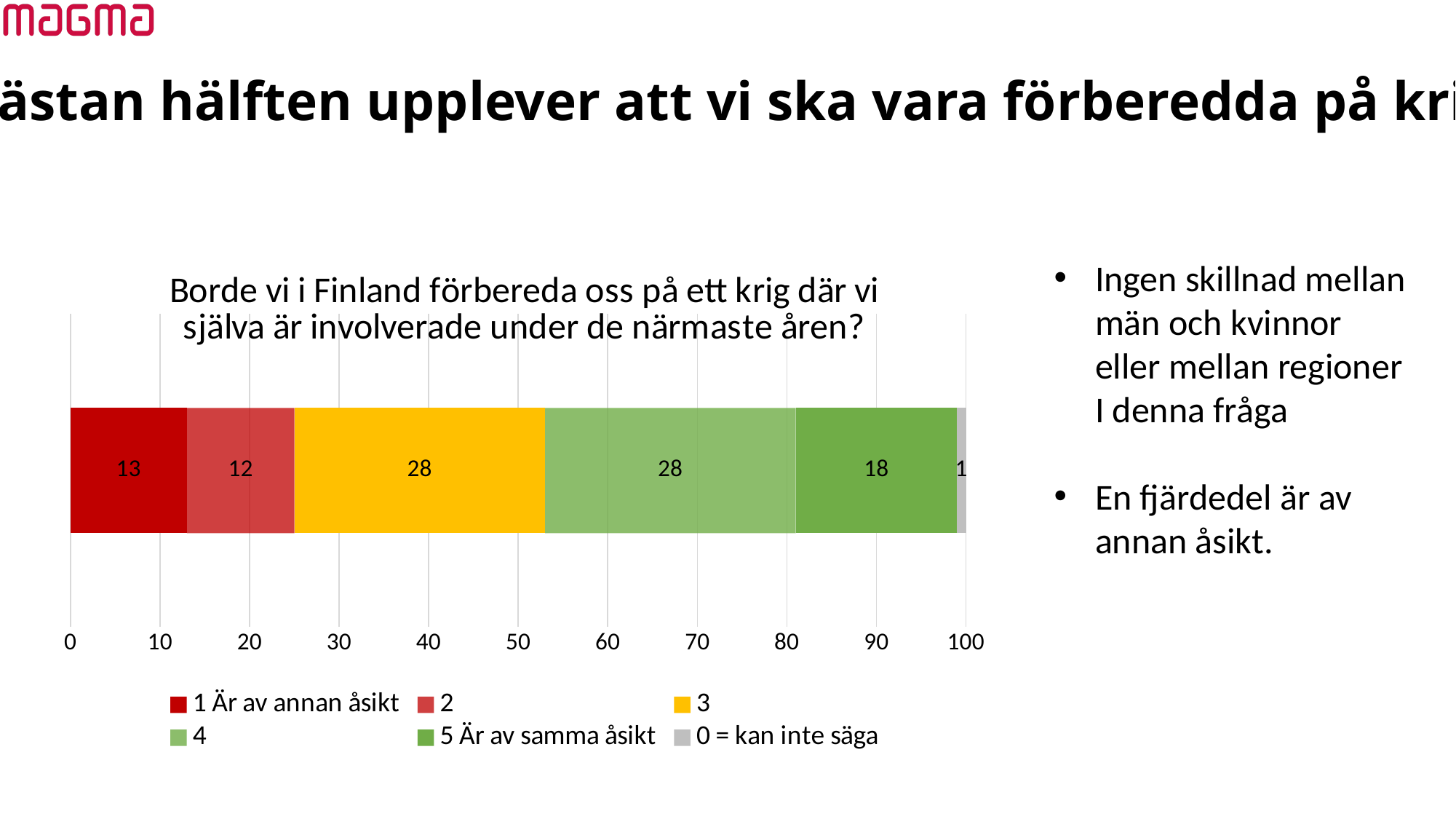
What is the value for the series "1 Är av annan åsikt"? 13 How many series does the legend list? 6 What is the value for the series "0 = kan inte säga"? 1 What is the value for the series "5 Är av samma åsikt"? 18 Which series has the smallest value in the bar? 0 = kan inte säga What is the total of the stacked bar? 100 What colour is the segment for the series "3"? Yellow Which is larger, the value for "1 Är av annan åsikt" or the value for "2"? 1 Är av annan åsikt What kind of chart is shown on the slide? Stacked bar chart What is the difference between the value for "5 Är av samma åsikt" and the value for "1 Är av annan åsikt"? 5 What is the value for the series "2"? 12 What is the title of the chart? Borde vi i Finland förbereda oss på ett krig där vi själva är involverade under de närmaste åren?